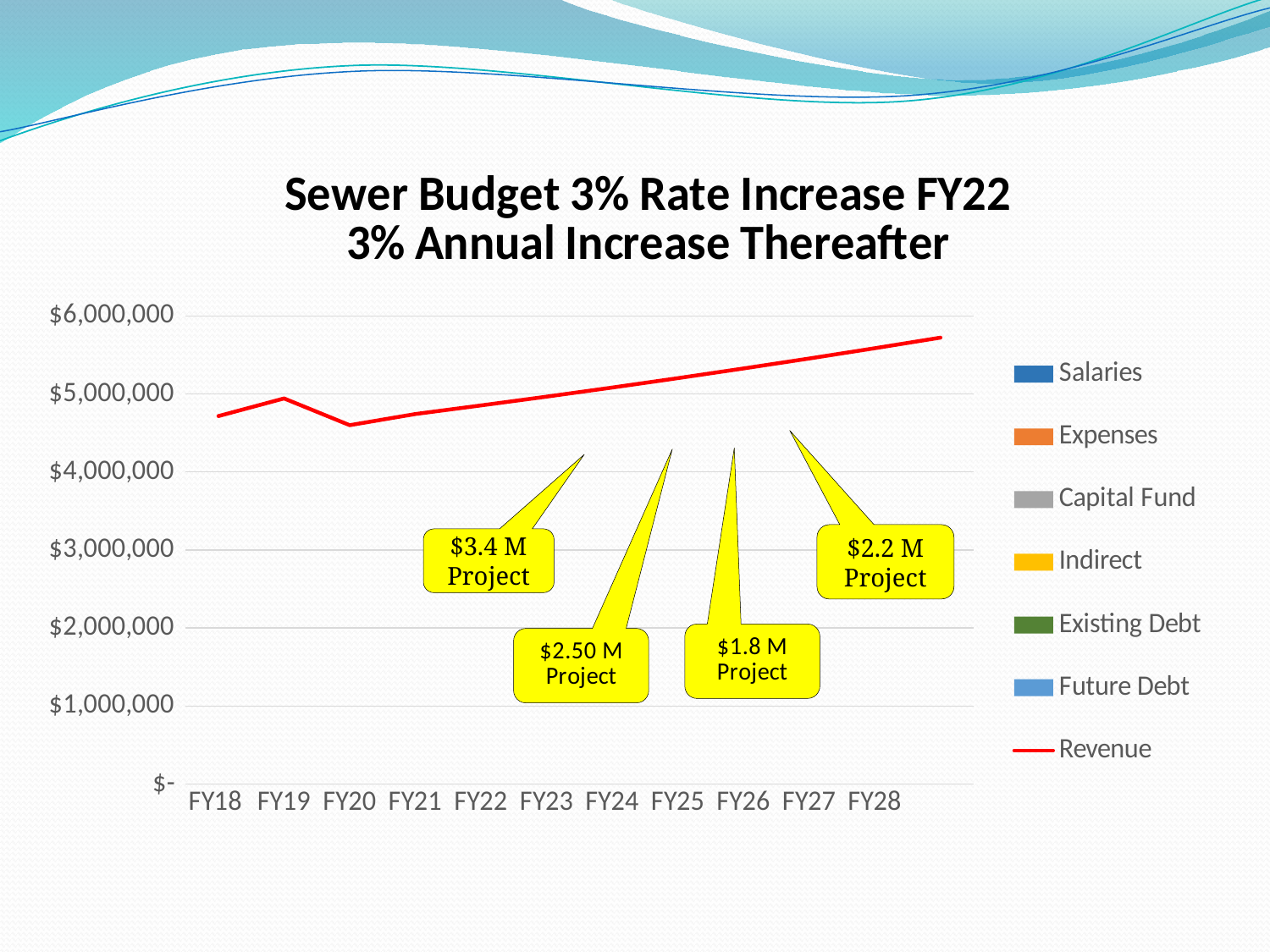
In which fiscal year is Revenue highest? FY28 Is the Revenue value for FY18 greater or less than $5,000,000? less Does Revenue rise or fall from FY20 to FY28? rise Is the Revenue value for FY24 greater or less than $4,000,000? greater Is the Revenue value for FY28 greater or less than $5,000,000? greater What is the title of the chart? Sewer Budget 3% Rate Increase FY22 3% Annual Increase Thereafter How many fiscal years are shown on the x axis? 11 Which has the larger Revenue value, FY19 or FY20? FY19 Which series is plotted as a red line? Revenue In which fiscal year is Revenue lowest? FY20 How many series does the chart legend list? 7